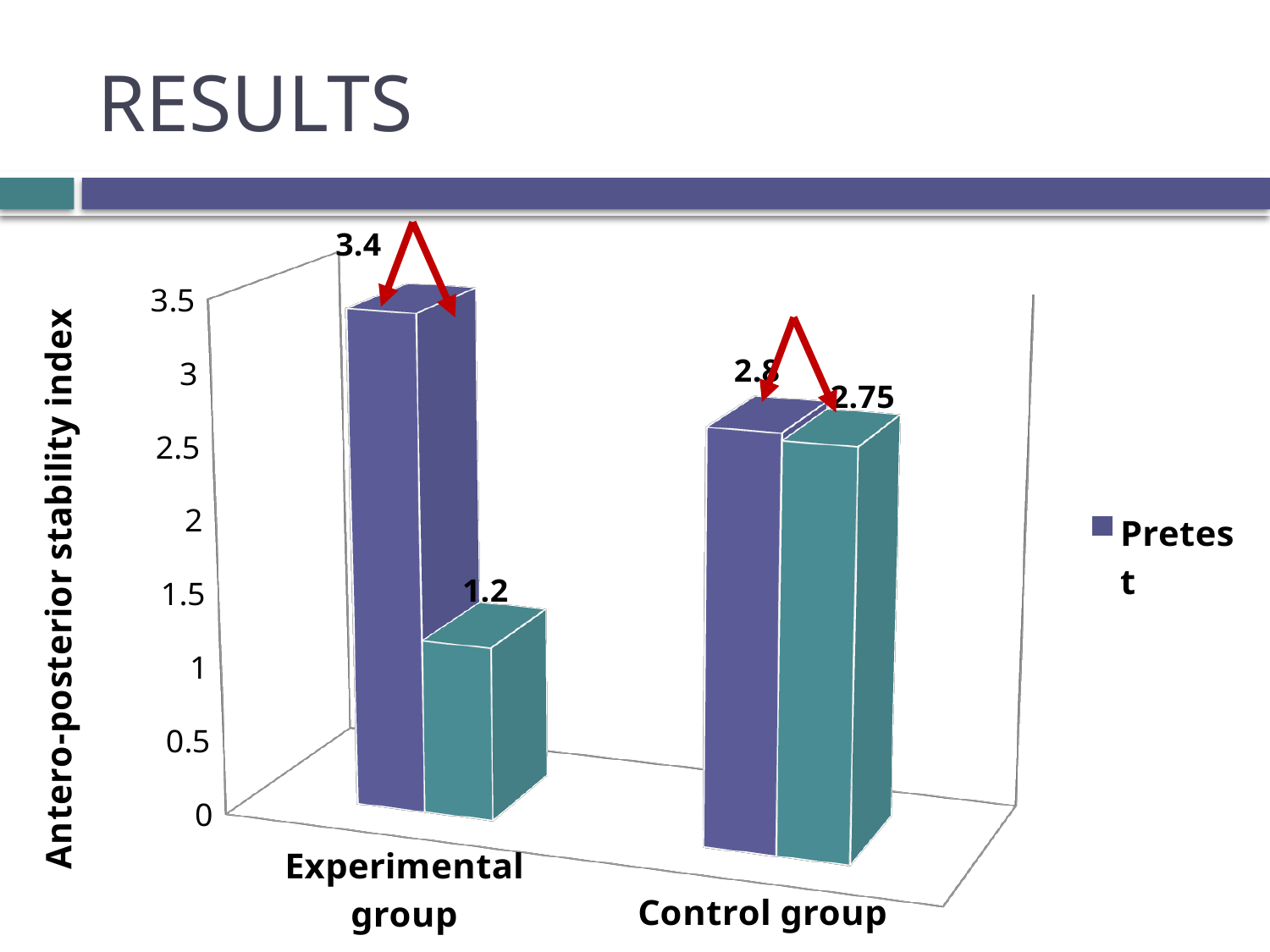
What is the label on the vertical axis of the chart? Antero-posterior stability index What value is labelled on the teal bar for the Experimental group? 1.2 What is the difference between the Pretest value and the teal bar value for the Experimental group? 2.2 What value is labelled on the teal bar for the Control group? 2.75 What is the difference between the Pretest value and the teal bar value for the Control group? 0.05 What is the Pretest value for the Control group? 2.8 Which bar on the chart has the lowest value? The teal bar for the Experimental group (1.2) Is the Pretest value for the Experimental group greater or less than 3? greater What kind of chart is shown on the slide? Bar chart Which group has the higher Pretest value? Experimental group What is the Pretest value for the Experimental group? 3.4 How many groups are shown on the x axis of the chart? 2